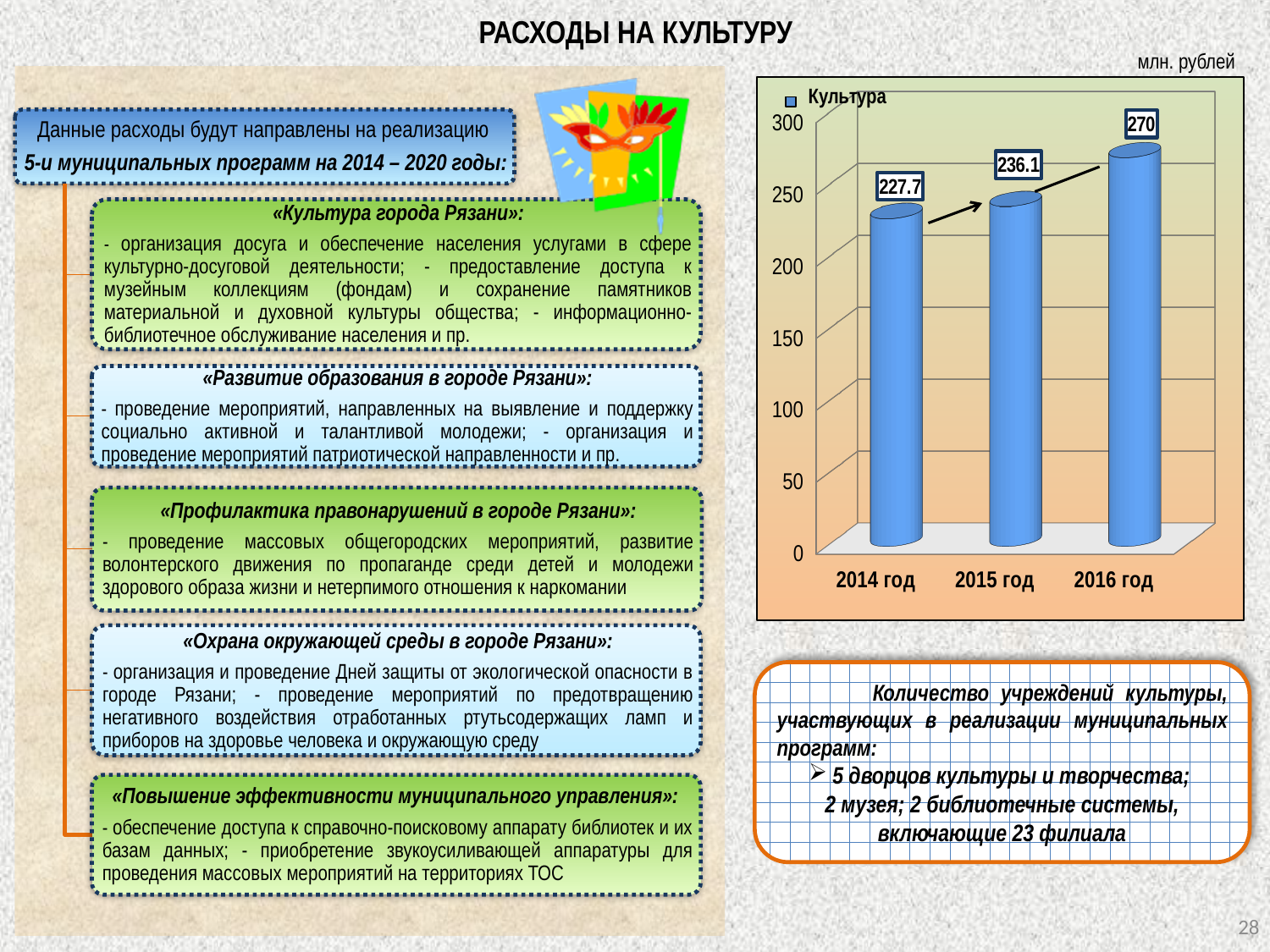
What is the value for 2015 год? 236.1 What kind of chart is shown? bar chart What is the value for 2016 год? 270 How many years are shown on the x axis? 3 Which is larger, the value for 2015 год or 2016 год? 2016 год What is the value for 2014 год? 227.7 What is the difference between the values for 2016 год and 2014 год? 42.3 Is the value for 2016 год greater or less than 250? greater Which year has the lowest value? 2014 год What is the difference between the values for 2015 год and 2014 год? 8.4 Do the values rise or fall from 2014 год to 2016 год? rise Which year has the highest value? 2016 год